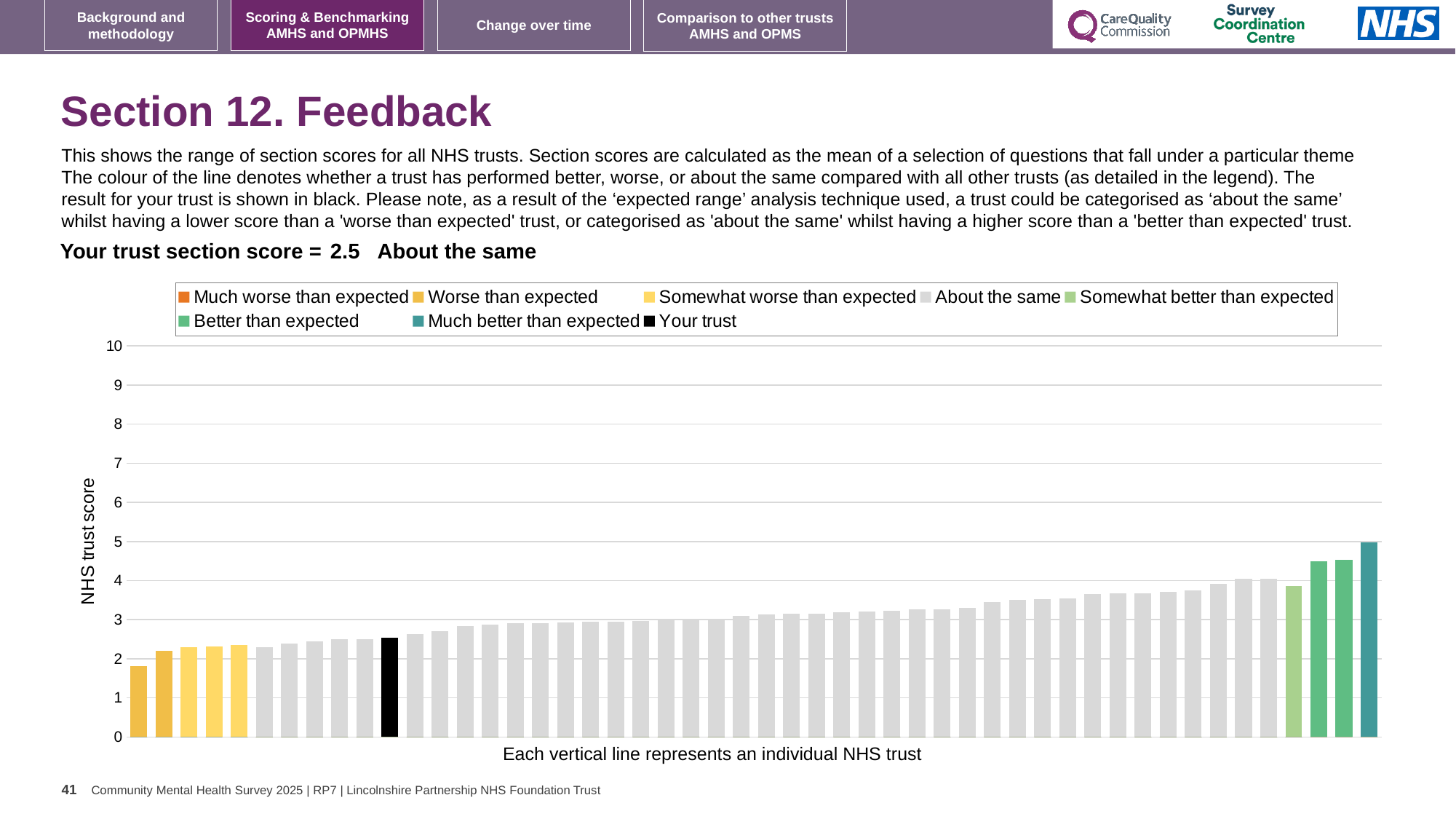
What is the section score for your trust shown on the slide? 2.5 What is the highest value shown on the vertical axis of the chart? 10 Is the value for the trust shown in black greater or less than 3? less What is the label on the vertical axis of the chart? NHS trust score According to the slide, how is your trust's section score categorised compared with other trusts? About the same What kind of chart is shown on the slide? bar chart How many entries does the chart legend list? 8 Is the value of the tallest bar in the chart greater or less than 4? greater Is the value of the shortest bar in the chart greater or less than 2? less Do the bar values rise or fall from left to right along the x axis? rise